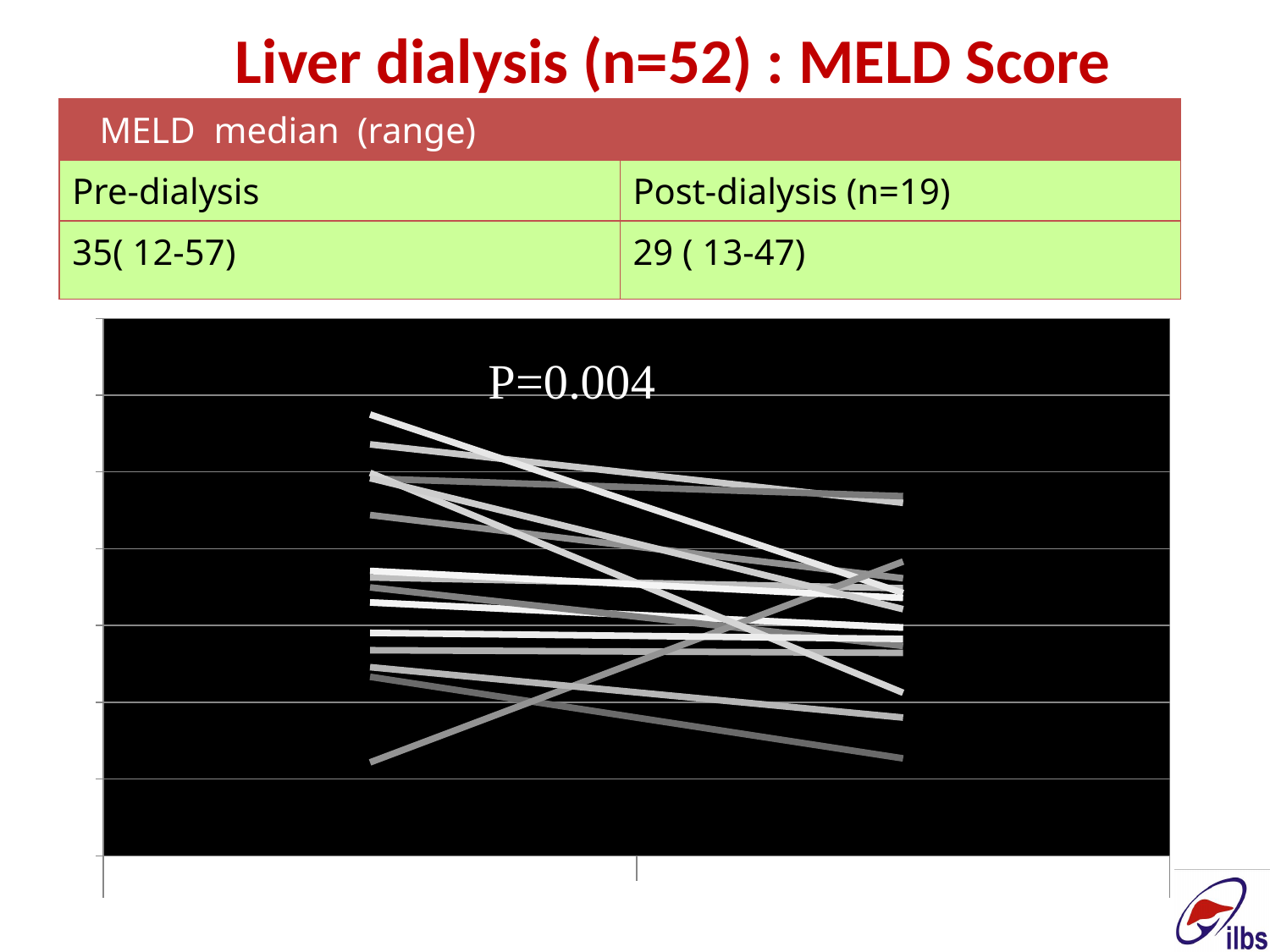
What kind of chart is shown on the slide? line chart What P value is printed on the chart? P=0.004 Do most of the lines in the chart rise or fall from left to right? fall How many lines in the chart clearly rise from left to right? 1 What is the background colour of the chart's plot area? black